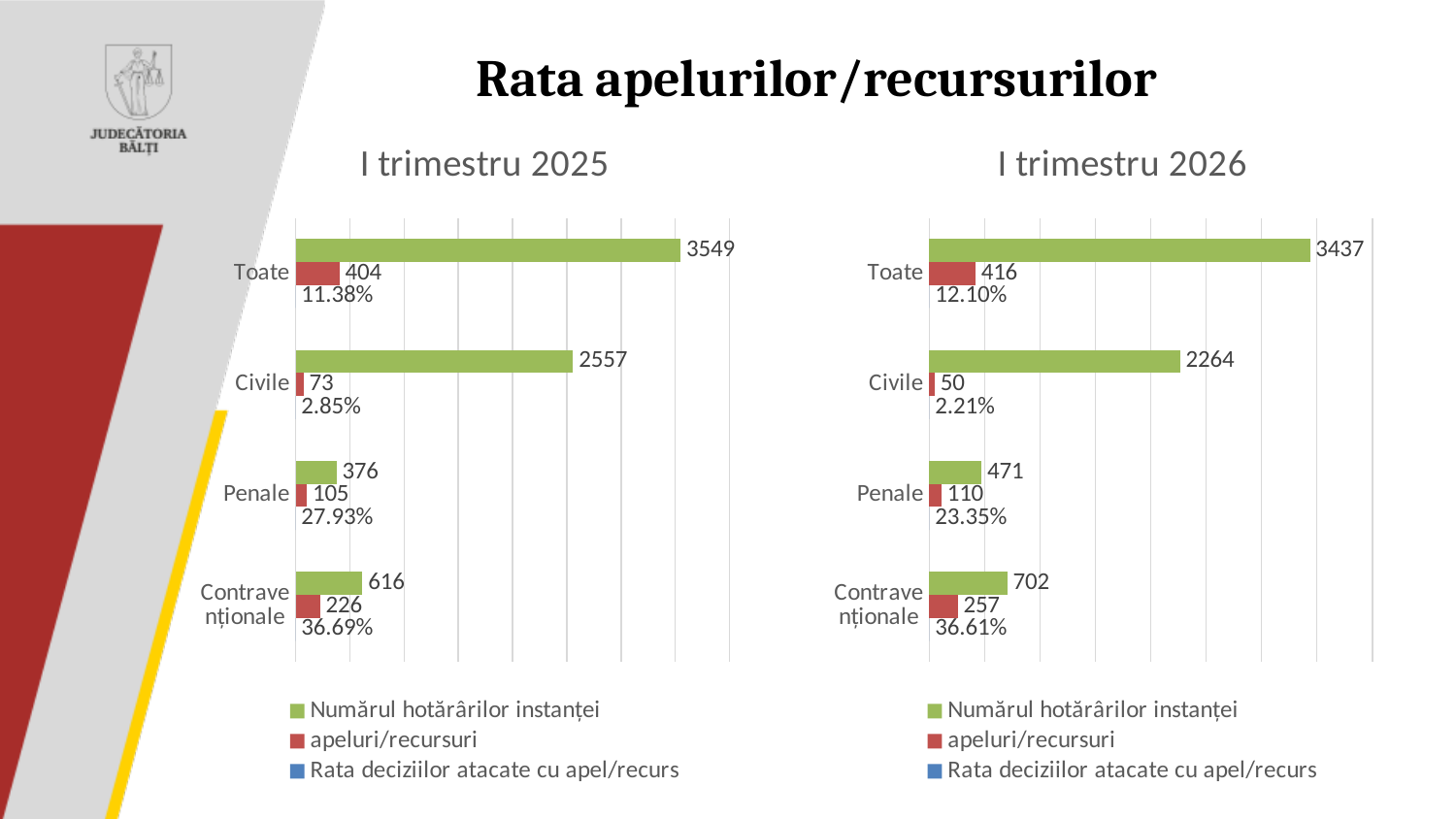
In the 'I trimestru 2026' chart, which category has the highest value of 'Numărul hotărârilor instanței'? Toate How many series does the legend of the 'I trimestru 2026' chart list? 3 In the 'I trimestru 2026' chart, what is the 'Rata deciziilor atacate cu apel/recurs' for Civile? 2.21% What type of chart is the 'I trimestru 2025' chart? Bar chart Which is larger: 'Numărul hotărârilor instanței' for Penale in the 'I trimestru 2025' chart or in the 'I trimestru 2026' chart? I trimestru 2026 In the 'I trimestru 2025' chart, which category has the lowest value of 'apeluri/recursuri'? Civile In the 'I trimestru 2025' chart, what is the value of 'Numărul hotărârilor instanței' for Toate? 3549 In the 'I trimestru 2026' chart, what is the value of 'apeluri/recursuri' for Contravenționale? 257 In the 'I trimestru 2026' chart, what is the difference between 'apeluri/recursuri' for Penale and for Civile? 60 In the 'I trimestru 2025' chart, what is the difference between 'Numărul hotărârilor instanței' for Toate and for Civile? 992 In the 'I trimestru 2025' chart, what is the 'Rata deciziilor atacate cu apel/recurs' for Penale? 27.93% How many categories are shown in the 'I trimestru 2025' chart? 4